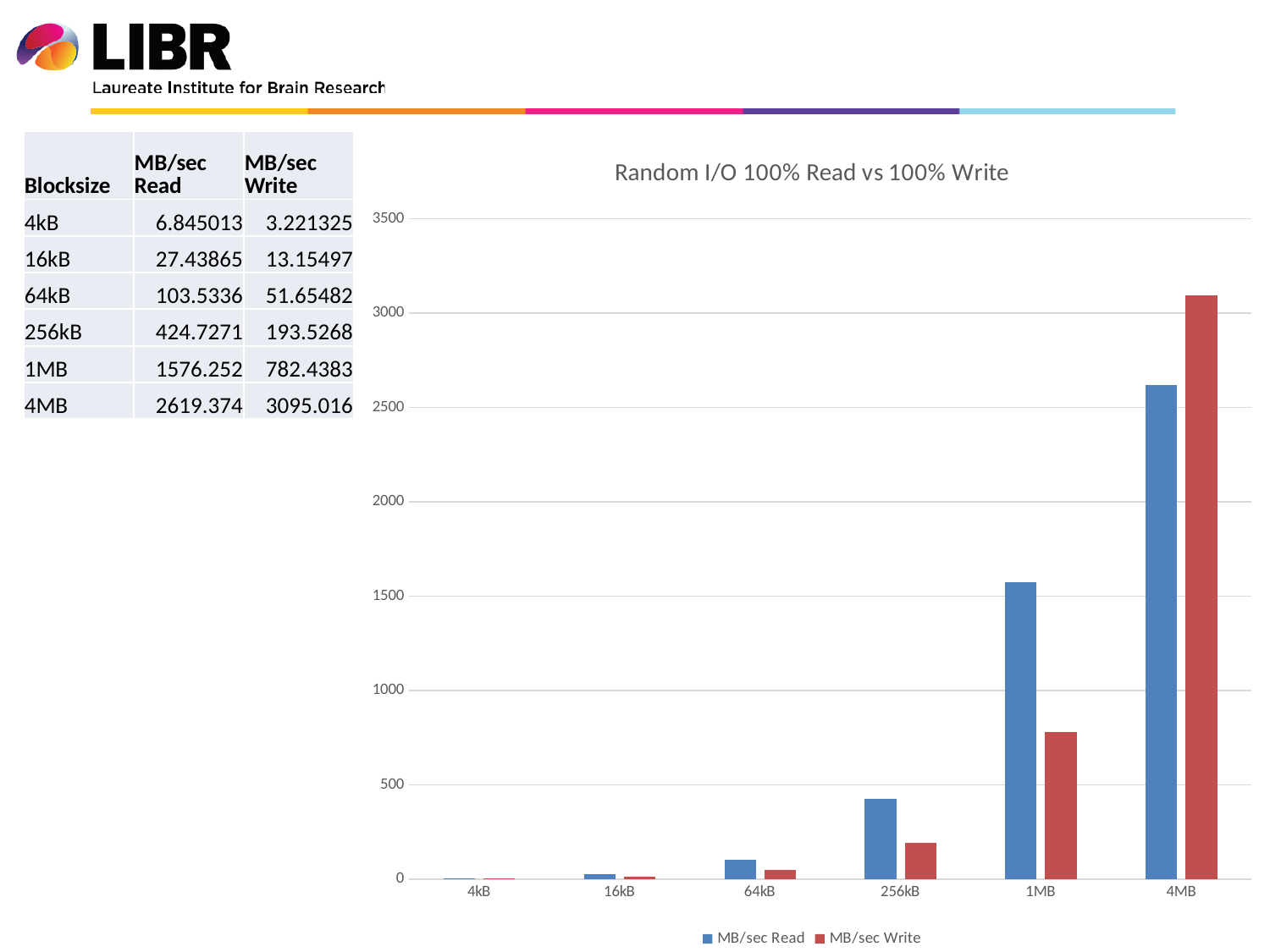
Is the MB/sec Read value for 4MB greater or less than 2500? greater For the 1MB blocksize, which is larger: MB/sec Read or MB/sec Write? MB/sec Read Which blocksize has the highest MB/sec Write value? 4MB How many series does the chart legend list? 2 How many blocksize categories are shown on the x axis of the chart? 6 What is the MB/sec Write value for the 256kB blocksize? 193.5268 What is the title of the chart? Random I/O 100% Read vs 100% Write Which blocksize has the lowest MB/sec Read value? 4kB What colour are the MB/sec Write bars in the chart? red What kind of chart is shown on the slide? bar chart Do the MB/sec Read values rise or fall as blocksize increases along the x axis? rise What is the MB/sec Read value for the 1MB blocksize? 1576.252